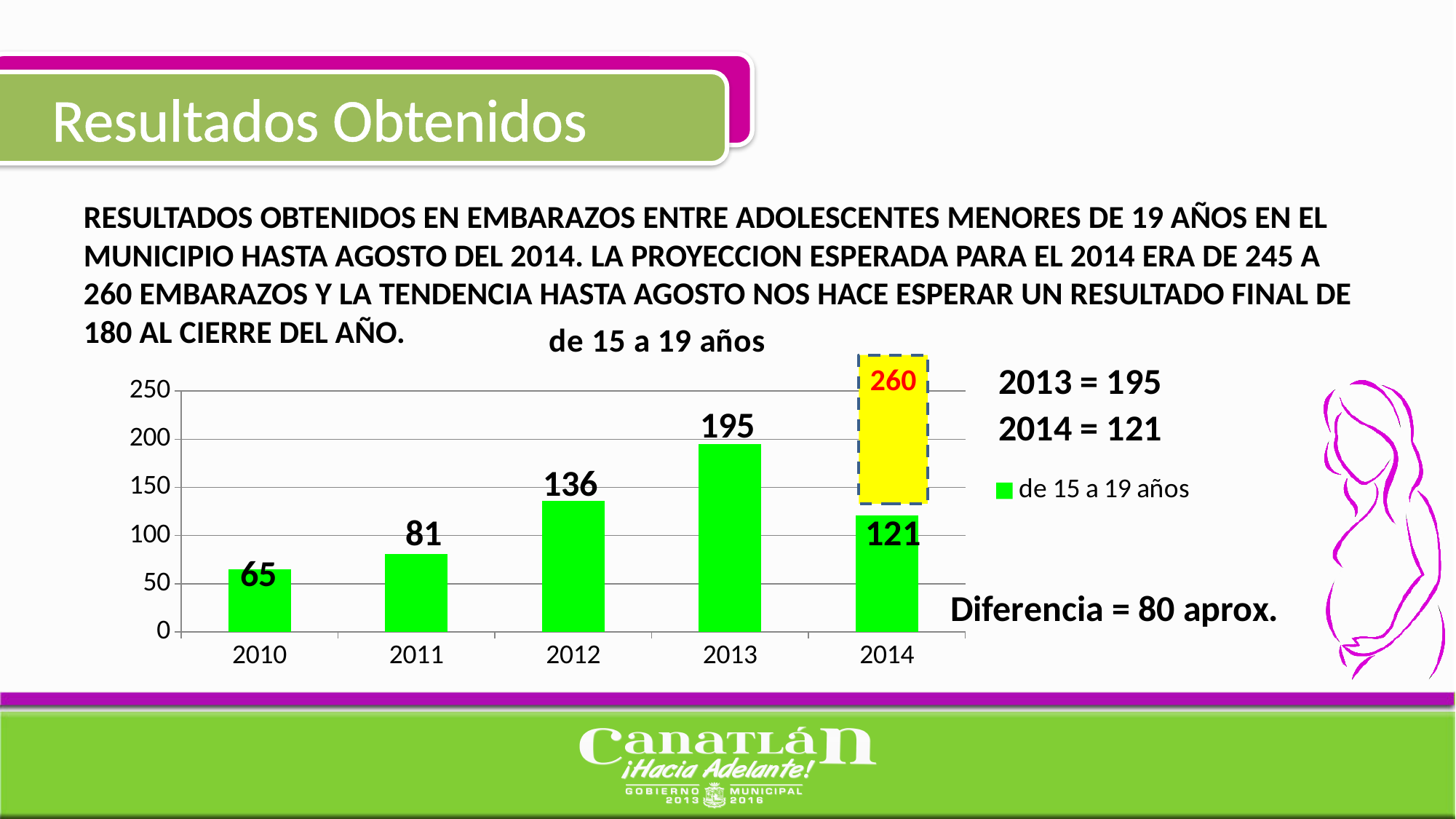
What is the title of the chart? de 15 a 19 años Which year has the lowest value? 2010 What is the value for 2014? 121 How many series does the legend list? 1 Which is larger, the value for 2011 or the value for 2014? 2014 What is the difference between the values for 2012 and 2011? 55 What is the value for 2010? 65 How many years are shown on the x axis? 5 What kind of chart is shown? bar chart What is the value for 2012? 136 What is the difference between the values for 2013 and 2014? 74 Which year has the highest value? 2013